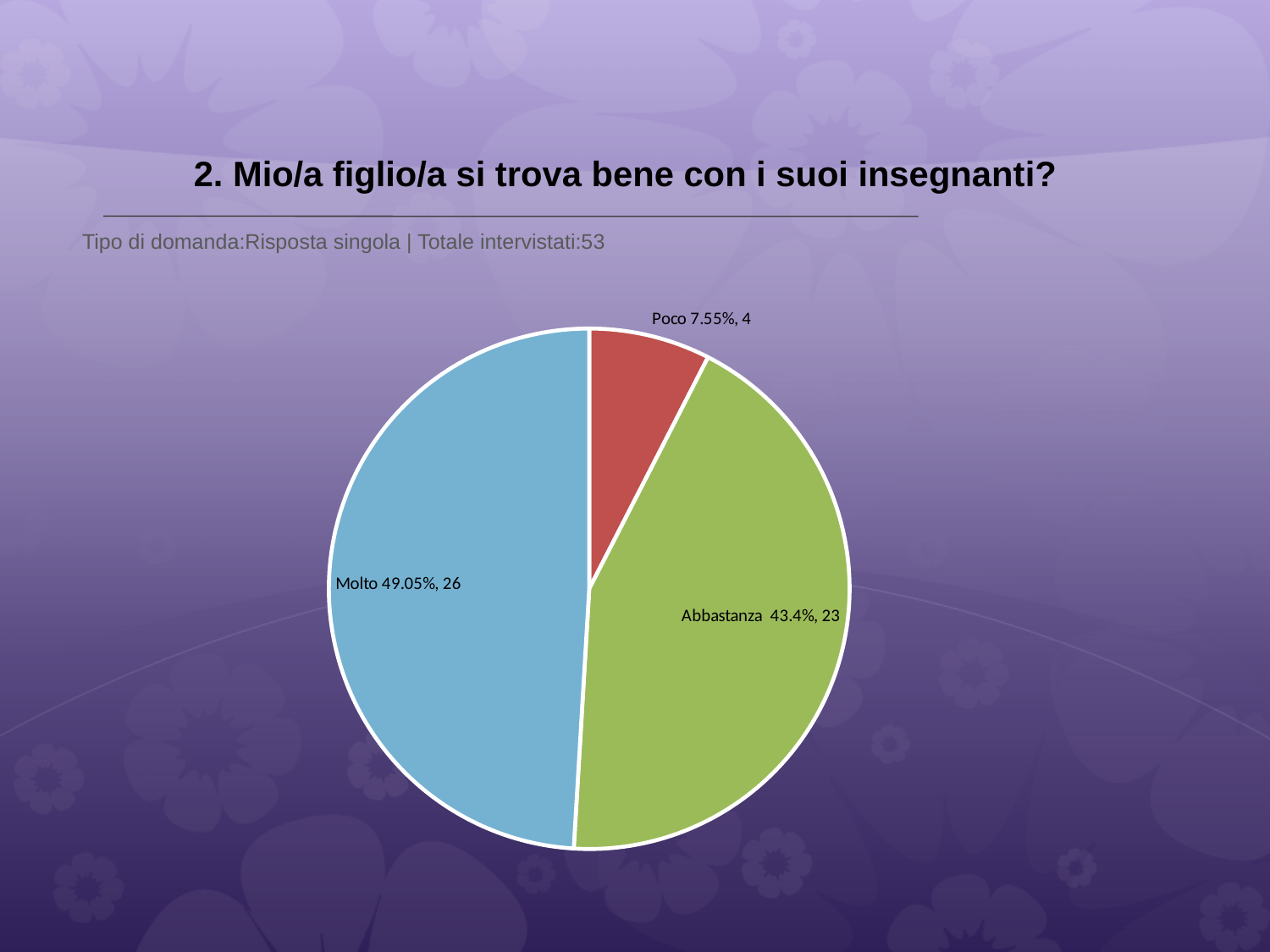
Which category has the smallest slice? Poco What percentage share does the Molto slice have? 49.05% What percentage share does the Abbastanza slice have? 43.4% How many respondents answered Abbastanza? 23 What is the difference in respondent count between Molto and Abbastanza? 3 What kind of chart is shown on the slide? pie chart How many respondents answered Molto? 26 What colour is the Abbastanza slice? green How many respondents answered Poco? 4 Which category has the largest slice? Molto What percentage share does the Poco slice have? 7.55% How many slices does the pie chart have? 3